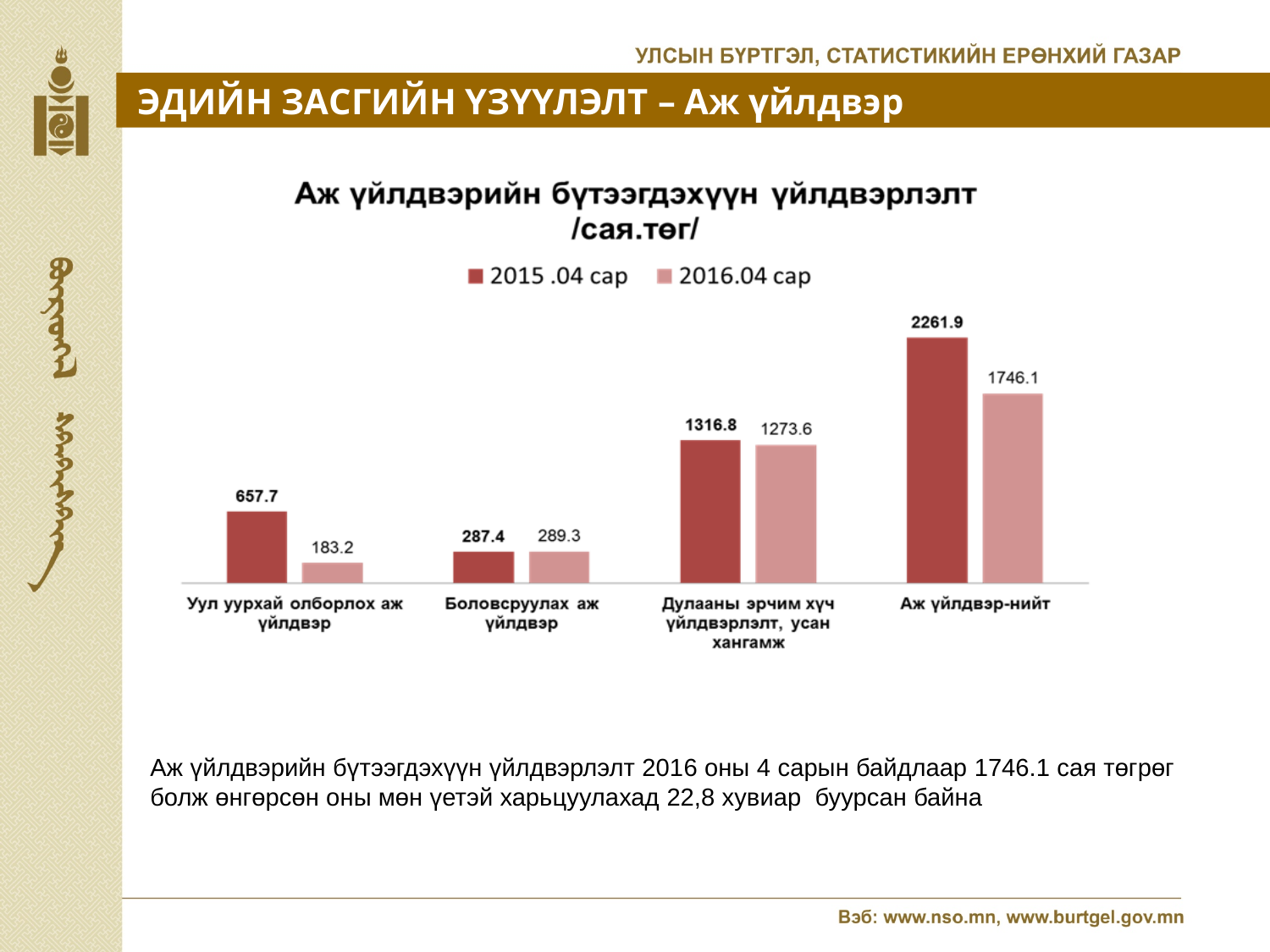
What is the value for Уул уурхай олборлох аж үйлдвэр in the 2015 .04 сар series? 657.7 Which category has the lowest value in the 2016.04 сар series? Уул уурхай олборлох аж үйлдвэр For Уул уурхай олборлох аж үйлдвэр, which series has the larger value, 2015 .04 сар or 2016.04 сар? 2015 .04 сар What is the title of the chart? Аж үйлдвэрийн бүтээгдэхүүн үйлдвэрлэлт /сая.төг/ What is the value for Боловсруулах аж үйлдвэр in the 2016.04 сар series? 289.3 What is the value for Аж үйлдвэр-нийт in the 2016.04 сар series? 1746.1 What is the value for Дулааны эрчим хүч үйлдвэрлэлт, усан хангамж in the 2015 .04 сар series? 1316.8 What is the difference between the 2015 .04 сар and 2016.04 сар values for Аж үйлдвэр-нийт? 515.8 Which category has the highest value in the 2015 .04 сар series? Аж үйлдвэр-нийт What type of chart is shown on the slide? bar chart How many series does the legend list? 2 How many categories are shown on the x axis? 4